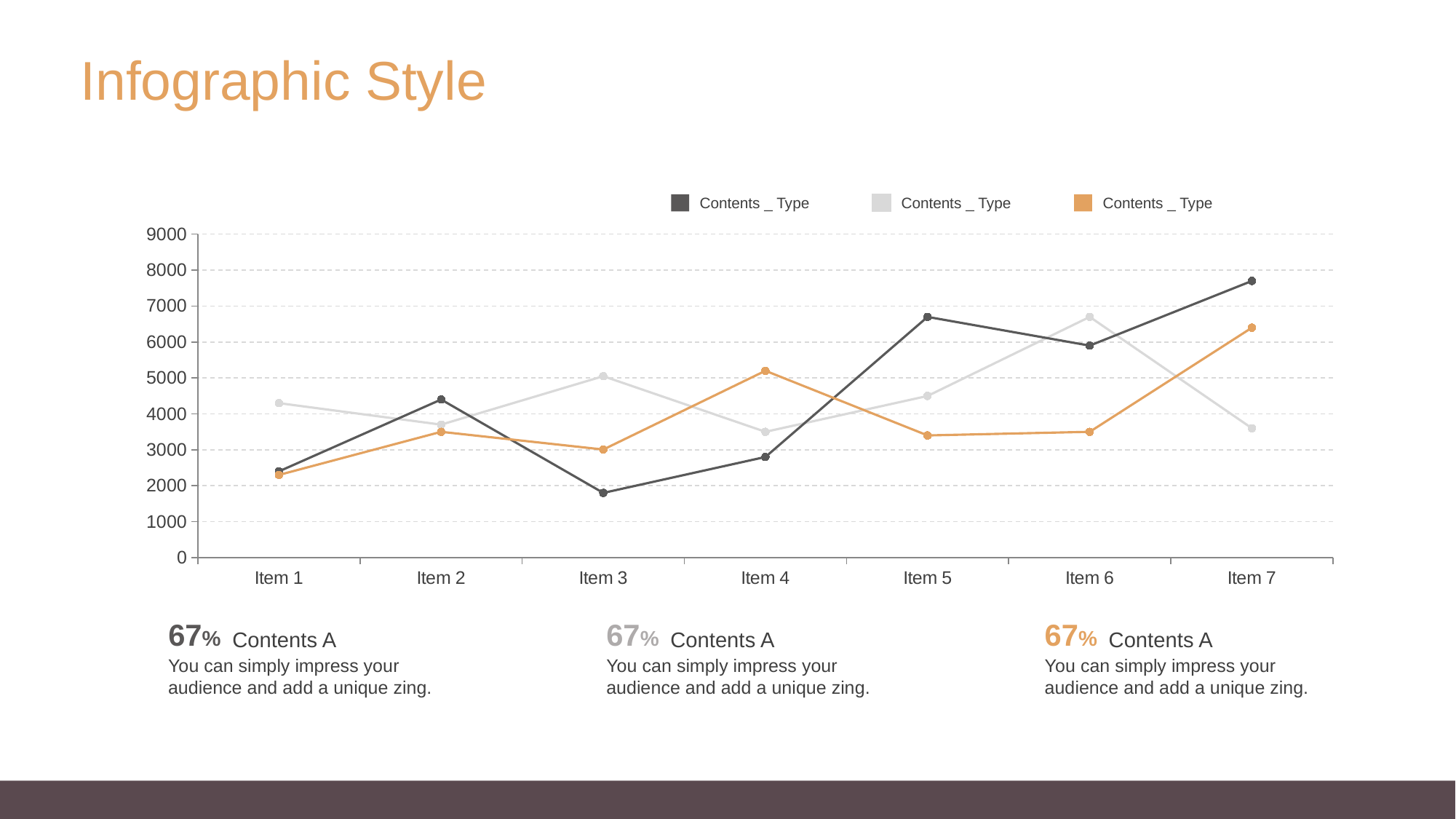
What kind of chart is shown on the slide? line chart Is the value of the dark grey line at Item 3 greater or less than 2000? less How many items are plotted along the x axis of the chart? 7 At which item does the orange line reach its highest value? Item 7 Is the value of the dark grey line at Item 7 greater or less than 7000? greater At which item does the dark grey line reach its highest value? Item 7 Is the value of the orange line at Item 4 greater or less than 4000? greater At which item does the dark grey line reach its lowest value? Item 3 At Item 5, which line has the larger value, the dark grey line or the orange line? the dark grey line How many series does the chart's legend list? 3 Does the dark grey line rise or fall from Item 6 to Item 7? rise